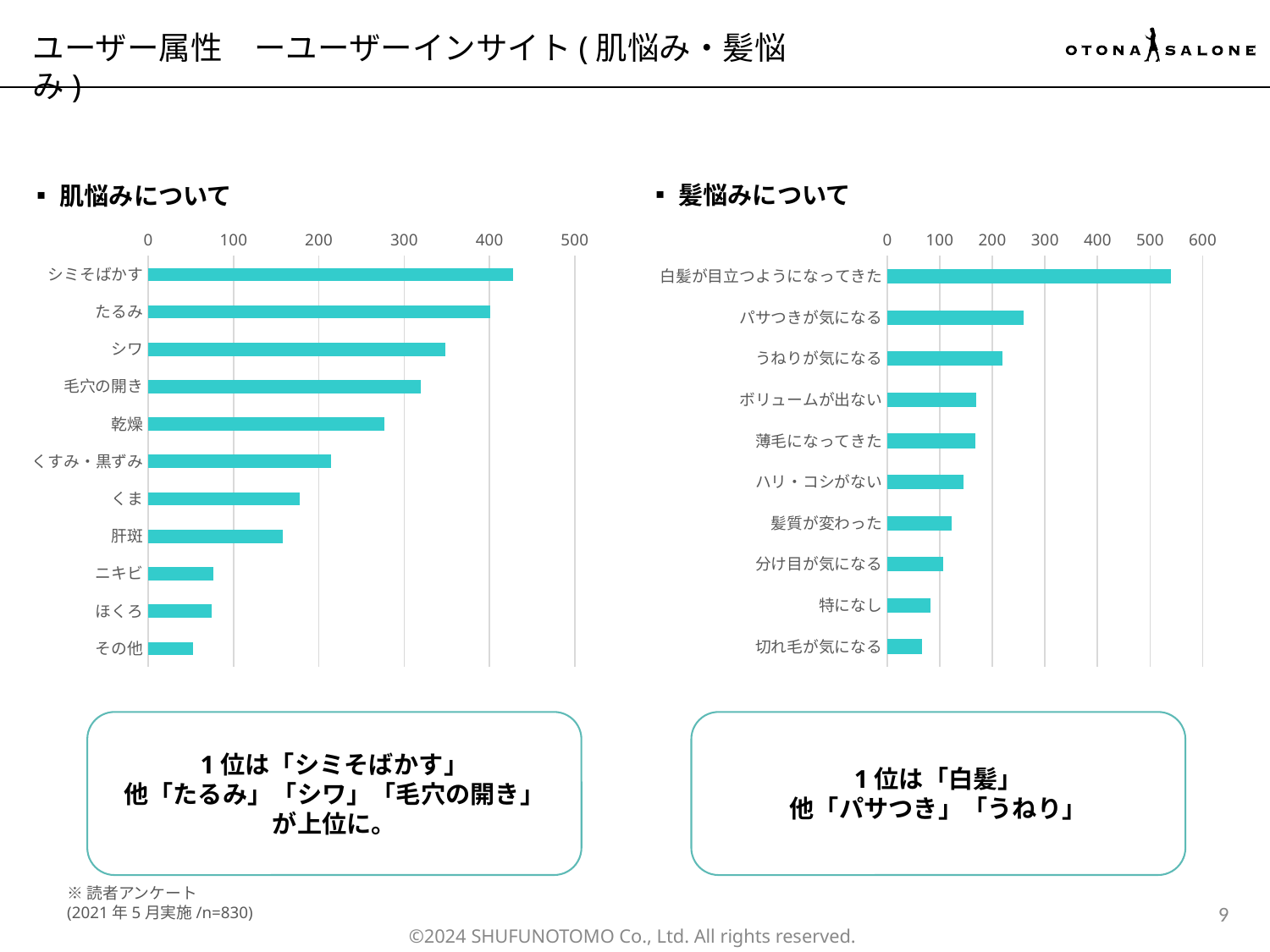
In the 肌悩みについて chart, which category has the lowest value? その他 In the 髪悩みについて chart, which category has the lowest value? 切れ毛が気になる In the 肌悩みについて chart, which category has the highest value? シミそばかす In the 肌悩みについて chart, is the value for シミそばかす greater or less than 400? greater How many categories are shown in the 肌悩みについて chart? 11 How many categories are shown in the 髪悩みについて chart? 10 In the 肌悩みについて chart, is the value for 乾燥 greater or less than 300? less In the 髪悩みについて chart, is the value for パサつきが気になる greater or less than 300? less In the 髪悩みについて chart, which category has the highest value? 白髪が目立つようになってきた In the 肌悩みについて chart, which is larger, たるみ or シワ? たるみ What type of chart is the 髪悩みについて chart? bar chart